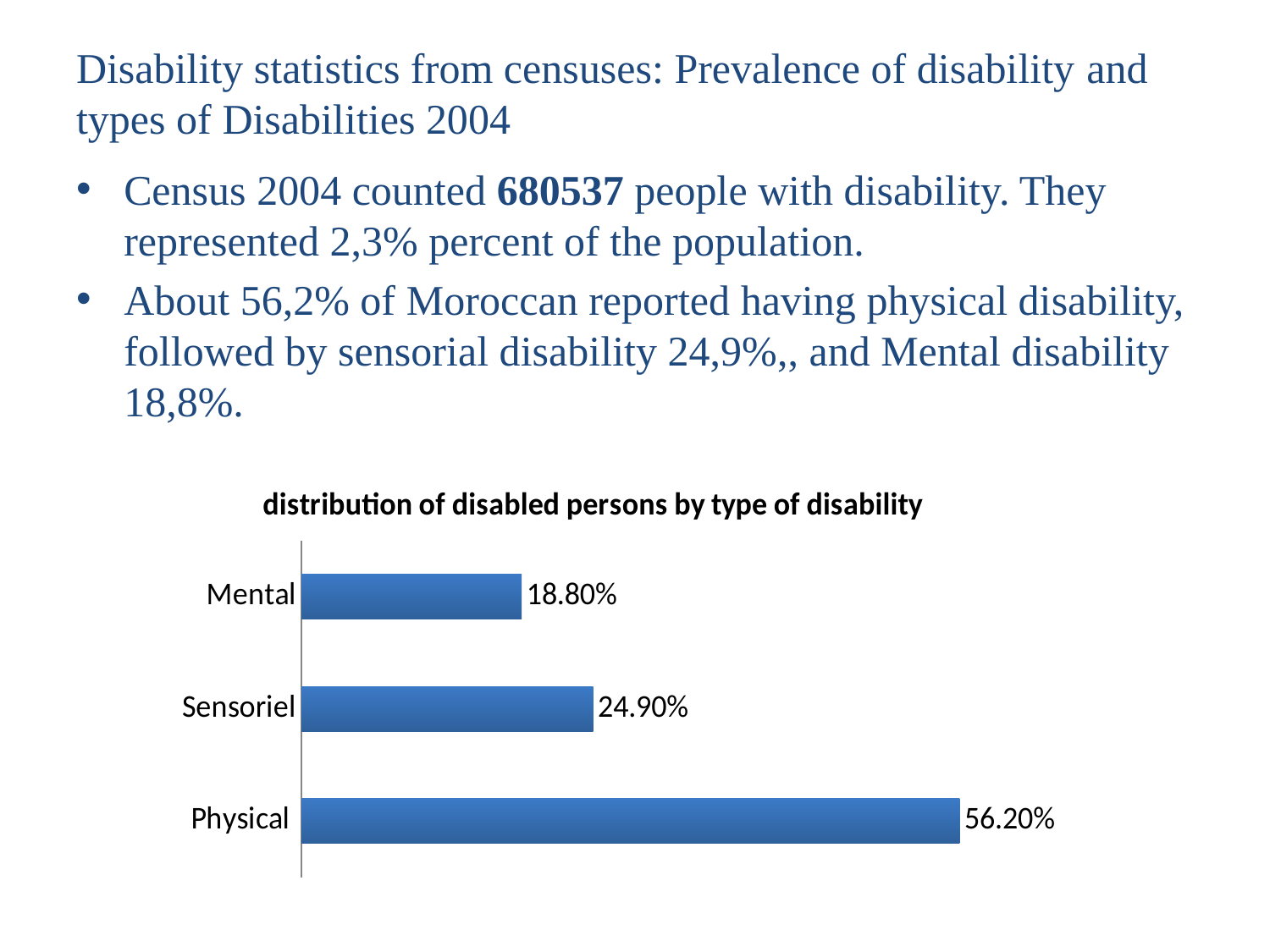
What is the value for Sensoriel in the chart? 24.90% Which is larger, the value for Sensoriel or the value for Mental? Sensoriel What is the difference between the values for Sensoriel and Mental? 6.10% What is the difference between the values for Physical and Sensoriel? 31.30% How many categories are shown in the chart? 3 What is the value for Physical in the chart? 56.20% What is the total of the three values shown in the chart? 99.90% Which type of disability has the highest value in the chart? Physical What is the title of the chart? distribution of disabled persons by type of disability What kind of chart is shown on the slide? Bar chart Which type of disability has the lowest value in the chart? Mental What is the value for Mental in the chart? 18.80%